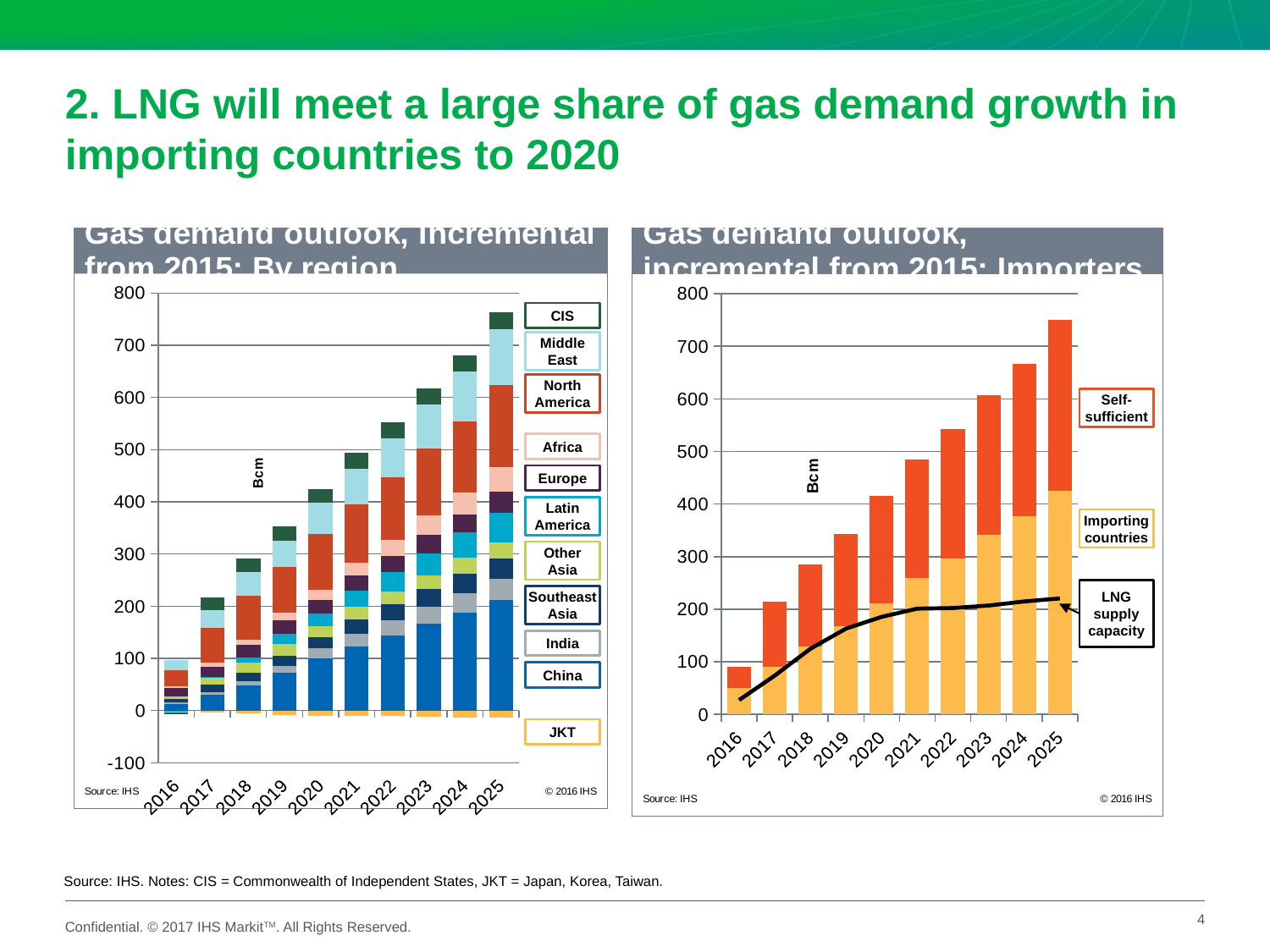
In the right chart, 'Gas demand outlook, incremental from 2015: Importers', is the Importing countries segment for 2025 greater or less than 400? greater What kind of chart is the left chart, 'Gas demand outlook, incremental from 2015: By region'? Stacked bar chart In the right chart, 'Gas demand outlook, incremental from 2015: Importers', which is larger in 2025: the Self-sufficient segment or the Importing countries segment? Importing countries How many years are shown on the x axis of the right chart, 'Gas demand outlook, incremental from 2015: Importers'? 10 In the right chart, 'Gas demand outlook, incremental from 2015: Importers', is the total bar for 2016 greater or less than 100? less In the right chart, 'Gas demand outlook, incremental from 2015: Importers', do the total bars rise or fall from 2016 to 2025? Rise In the right chart, 'Gas demand outlook, incremental from 2015: Importers', is the LNG supply capacity line in 2025 greater or less than 300? less What unit is shown on the y axis of the left chart, 'Gas demand outlook, incremental from 2015: By region'? Bcm How many series does the legend of the left chart, 'Gas demand outlook, incremental from 2015: By region', list? 11 In the right chart, 'Gas demand outlook, incremental from 2015: Importers', which year has the lowest total bar? 2016 In the left chart, 'Gas demand outlook, incremental from 2015: By region', which year has the highest total bar? 2025